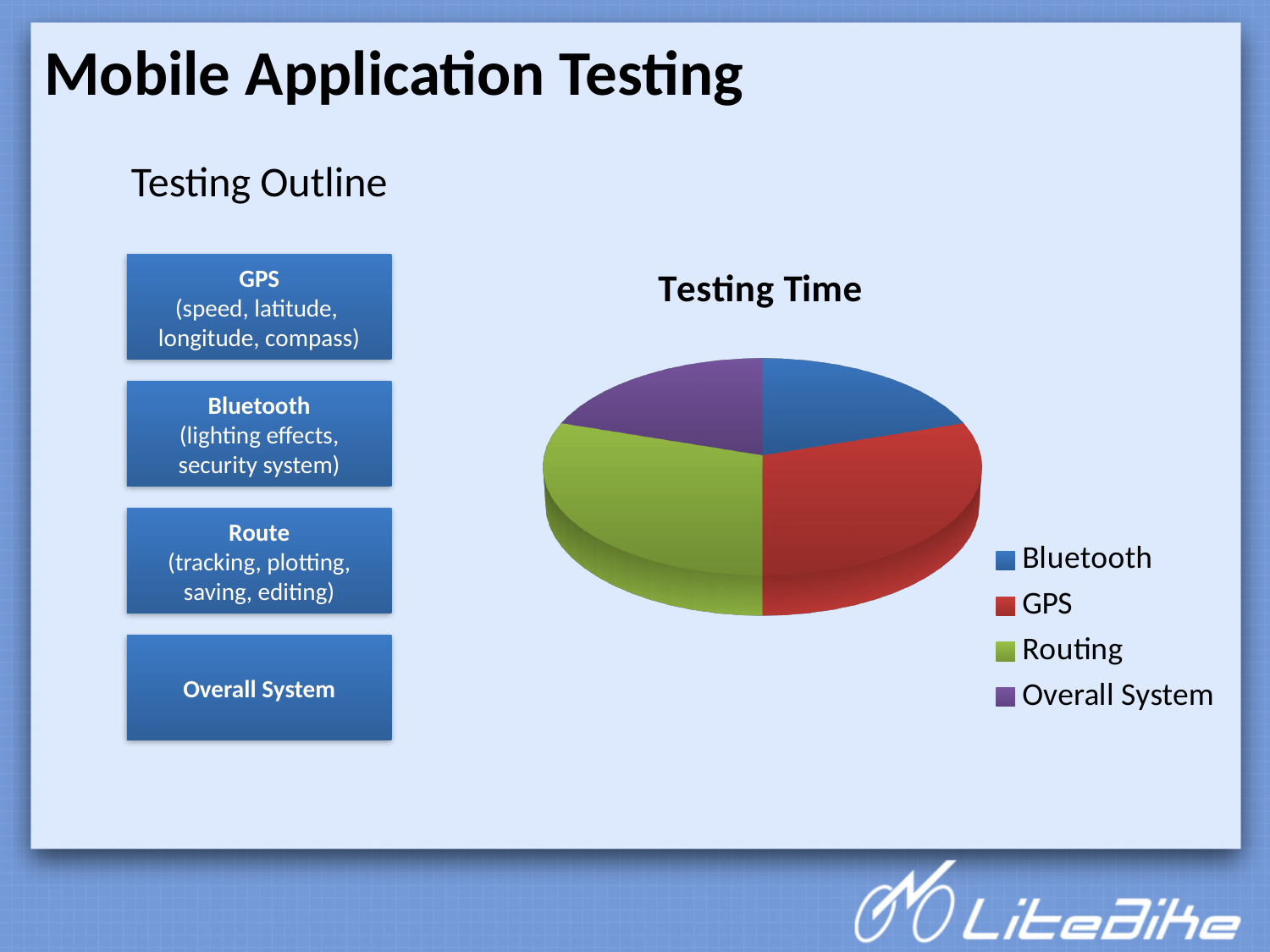
How many slices does the Testing Time pie chart have? 4 How many entries does the legend of the Testing Time chart list? 4 In the Testing Time chart, which is larger, the GPS slice or the Bluetooth slice? GPS What is the title of the chart? Testing Time In the Testing Time chart, which is larger, the Routing slice or the Overall System slice? Routing Which colour represents Routing in the Testing Time pie chart? green What kind of chart is shown on the slide? pie chart In the Testing Time chart, which is larger, the GPS slice or the Overall System slice? GPS